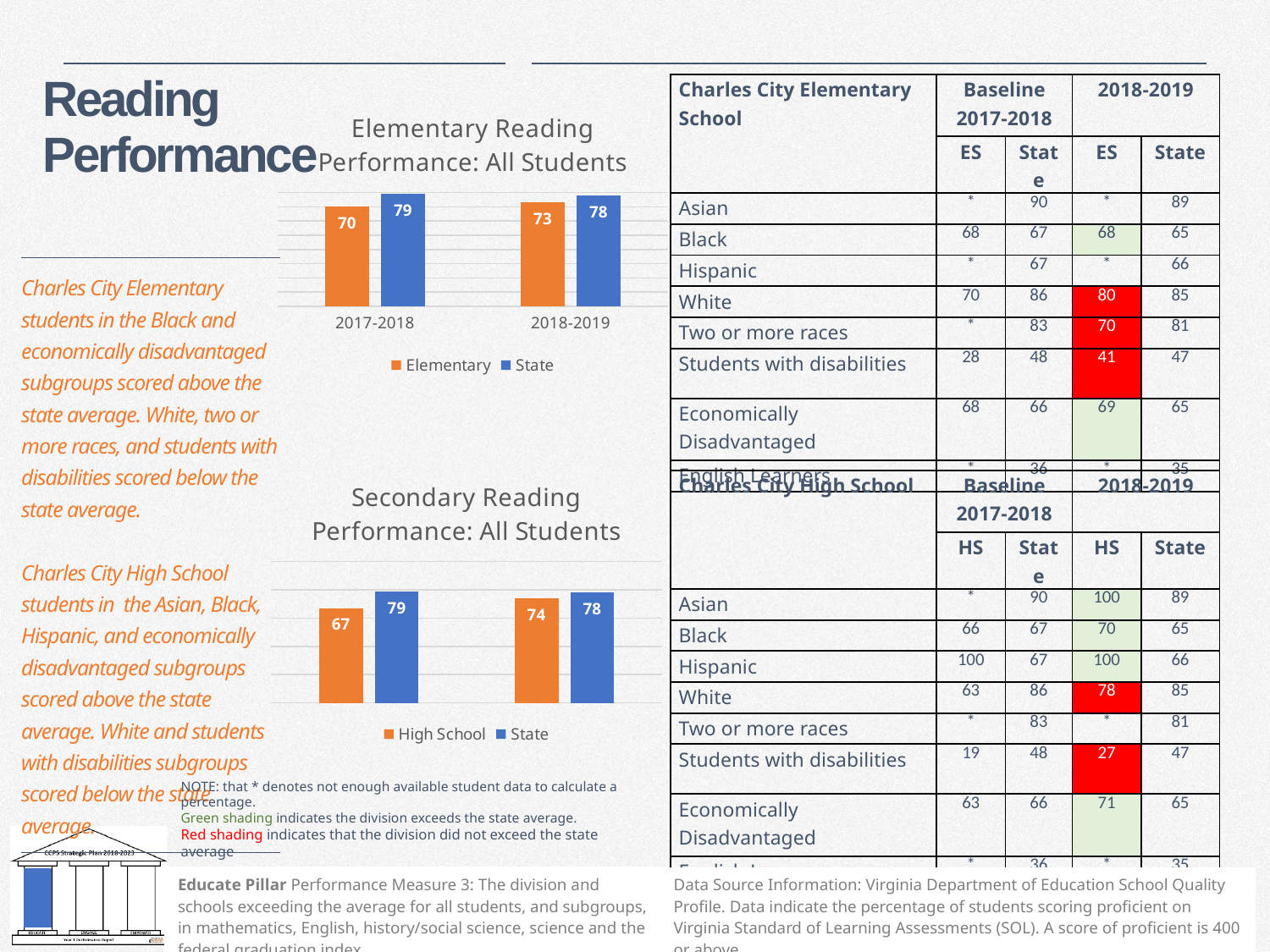
In the Secondary Reading Performance chart, what is the difference between the State and High School values for 2018-2019? 4 In the Secondary Reading Performance chart, what is the High School value for 2018-2019? 74 In the Elementary Reading Performance chart, what is the Elementary value for 2017-2018? 70 What kind of chart is the Elementary Reading Performance chart? bar chart In the Secondary Reading Performance chart, which year has the lowest High School value? 2017-2018 In the Elementary Reading Performance chart, did the Elementary value rise or fall from 2017-2018 to 2018-2019? rise How many series does the legend of the Secondary Reading Performance chart list? 2 In the Elementary Reading Performance chart, what is the State value for 2018-2019? 78 How many year categories are shown on the x axis of the Elementary Reading Performance chart? 2 In the Secondary Reading Performance chart, what is the High School value for 2017-2018? 67 In the Secondary Reading Performance chart, which is larger for 2017-2018, High School or State? State In the Elementary Reading Performance chart, what is the difference between the State and Elementary values for 2017-2018? 9